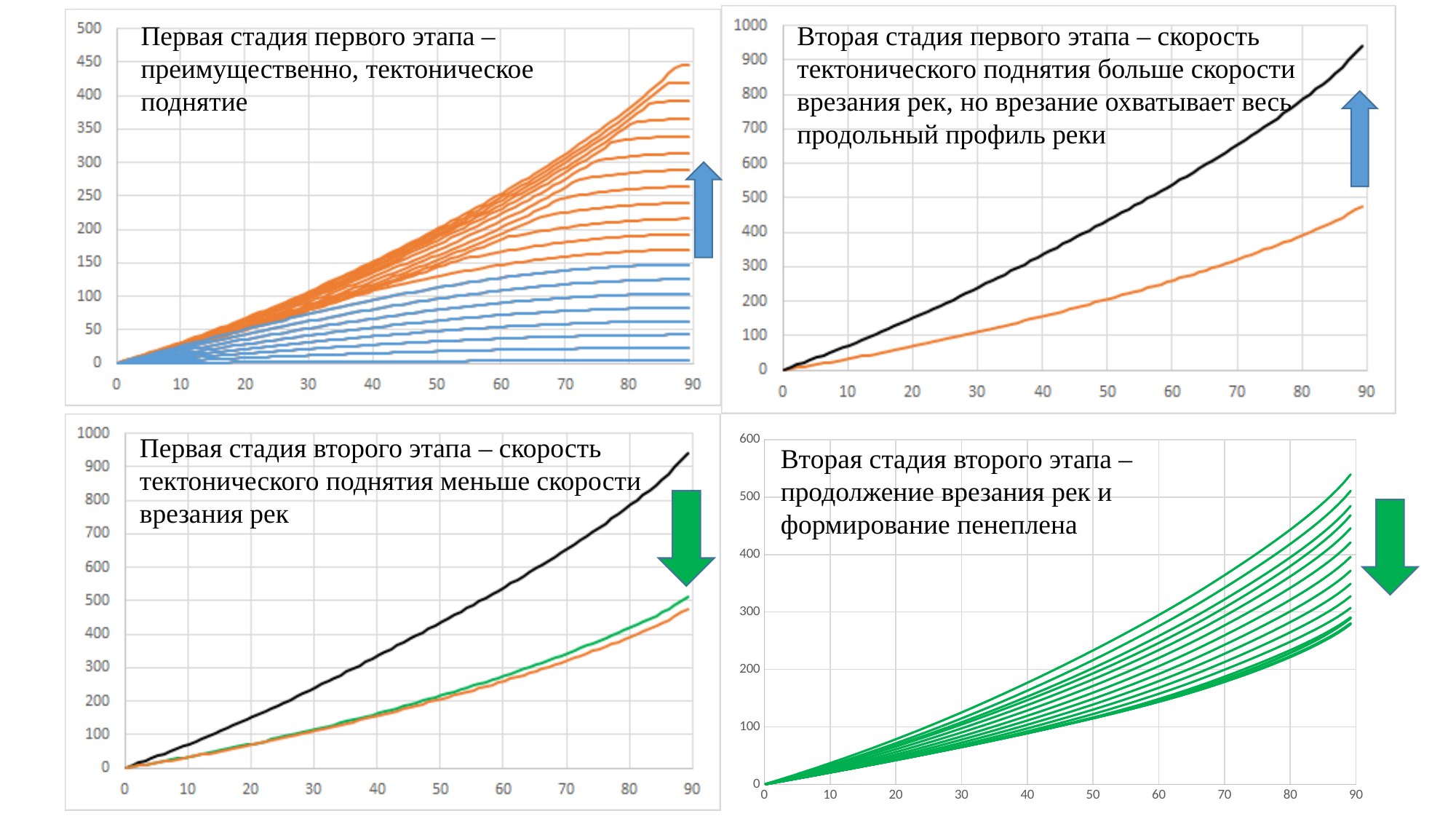
In the top-right chart, is the value of the orange line at x = 90 greater or less than 500? less In the bottom-right chart, is the value of the highest green line at x = 90 greater or less than 500? greater In the bottom-left chart, is the value of the orange line at x = 90 greater or less than 500? less In the top-right chart, which line has the larger value at x = 90, the black line or the orange line? the black line What kind of chart is the top-right chart on the slide? line chart In the bottom-left chart, which line has the larger value at x = 50, the black line or the orange line? the black line In the bottom-left chart, how many lines are plotted? 3 In the top-right chart, how many lines are plotted? 2 In the bottom-right chart, do the lines rise or fall as x increases from 0 to 90? rise What is the maximum value shown on the y axis of the top-right chart? 1000